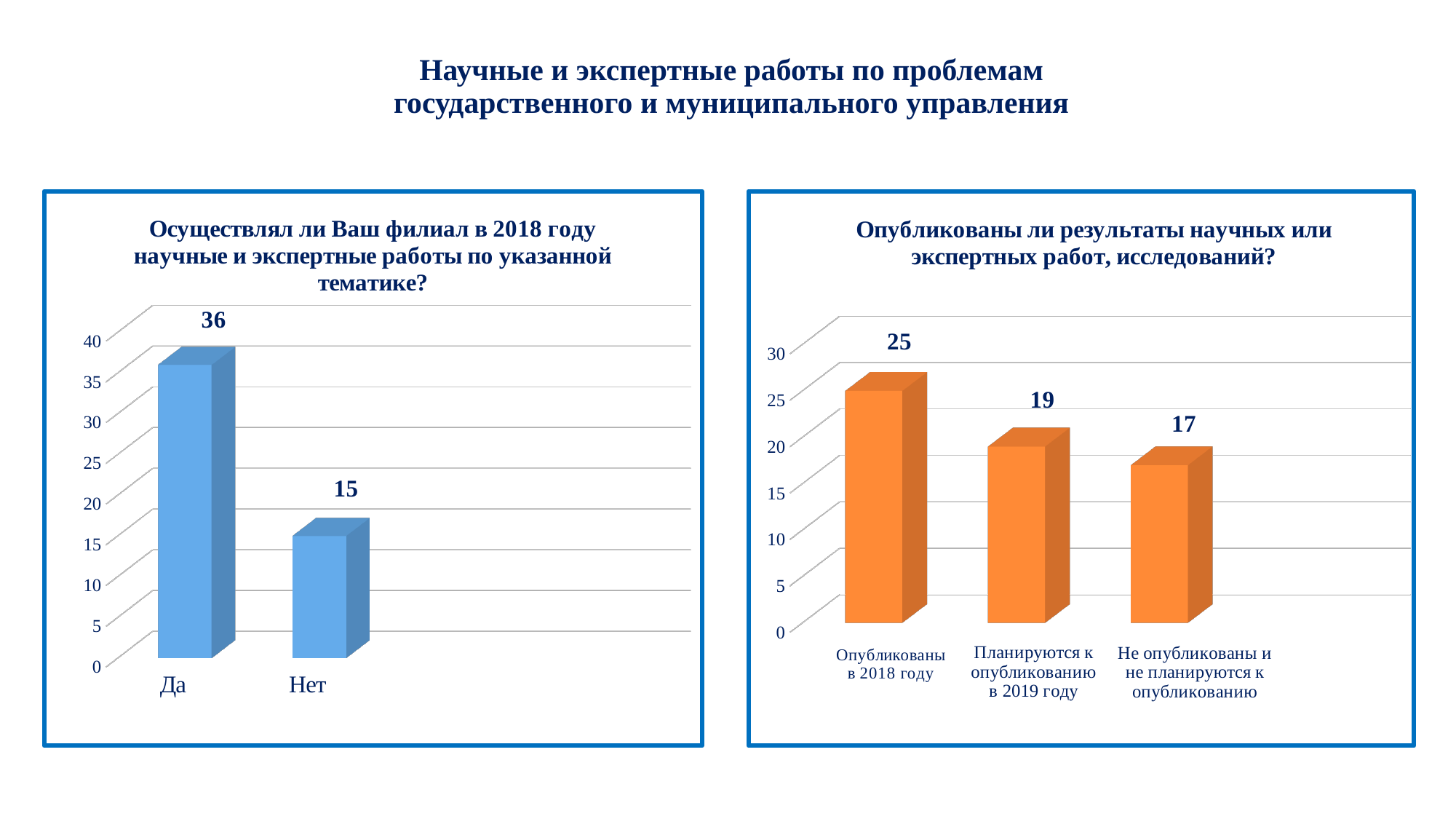
In the left chart, which category has the higher value, "Да" or "Нет"? Да In the right chart, which category has the lowest value? Не опубликованы и не планируются к опубликованию In the right chart, what is the difference between "Опубликованы в 2018 году" and "Не опубликованы и не планируются к опубликованию"? 8 In the left chart, what is the value for "Нет"? 15 In the right chart, what is the value for "Планируются к опубликованию в 2019 году"? 19 In the left chart ("Осуществлял ли Ваш филиал в 2018 году научные и экспертные работы по указанной тематике?"), what is the value for "Да"? 36 In the left chart, how many categories are shown? 2 In the left chart, what is the difference between the values for "Да" and "Нет"? 21 In the right chart, do the values rise or fall from left to right across the categories? Fall In the right chart, how many categories are shown? 3 In the right chart ("Опубликованы ли результаты научных или экспертных работ, исследований?"), what is the value for "Опубликованы в 2018 году"? 25 What type of chart is the left chart? Bar chart